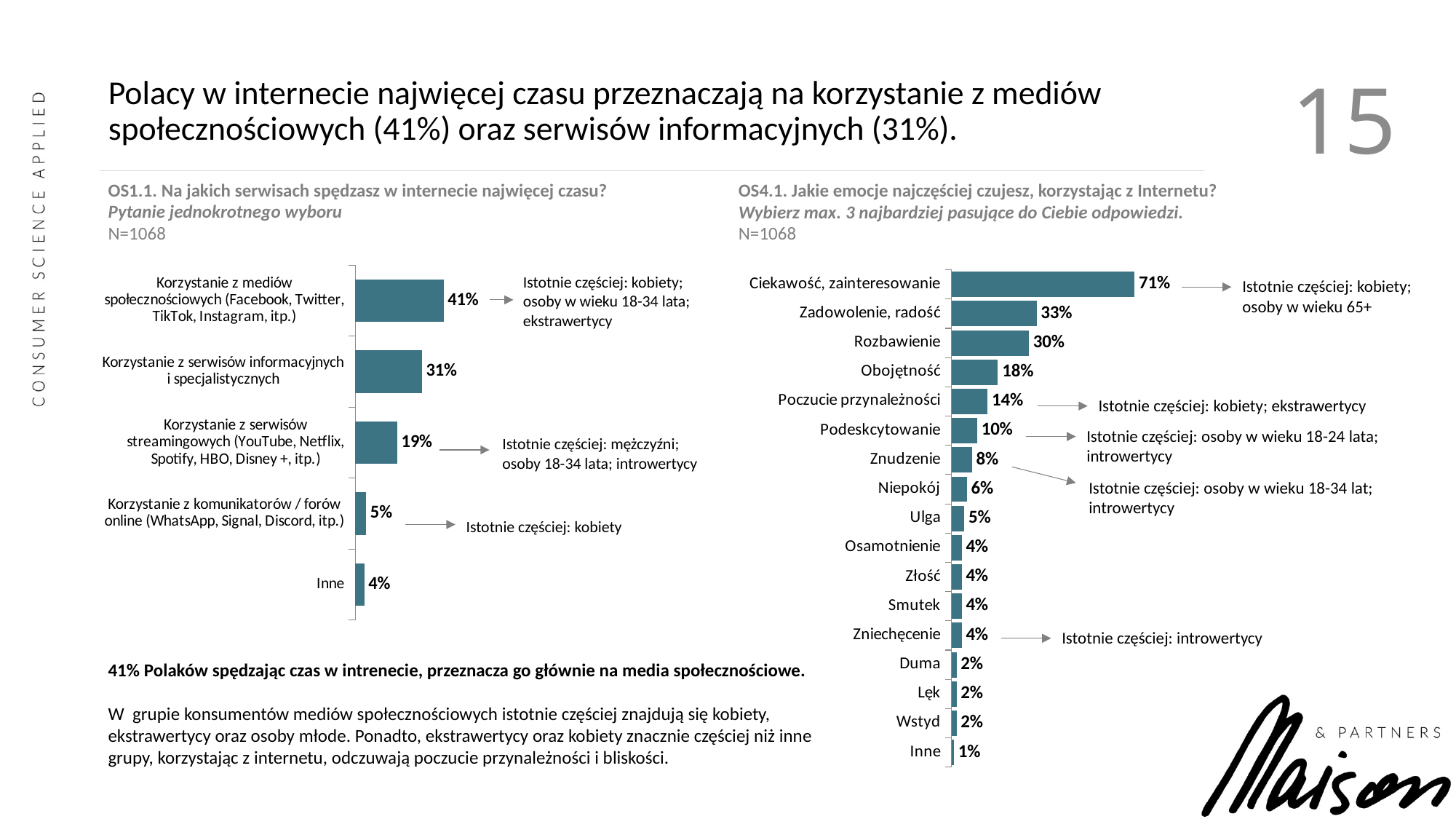
What is the sample size (N) stated for the left chart (OS1.1)? N=1068 In the left chart (OS1.1), what is the value for 'Korzystanie z serwisów informacyjnych i specjalistycznych'? 31% In the left chart (OS1.1), what is the difference between the values for social media (41%) and streaming services (19%)? 22 percentage points In the right chart (OS4.1), which category has the lowest value? Inne In the right chart (OS4.1), how many categories are shown? 17 In the right chart (OS4.1), what is the value for 'Niepokój'? 6% In the left chart (OS1.1), which category has the highest value? Korzystanie z mediów społecznościowych (Facebook, Twitter, TikTok, Instagram, itp.) In the right chart (OS4.1), which is larger: 'Obojętność' or 'Poczucie przynależności'? Obojętność In the left chart (OS1.1), how many categories are shown? 5 In the right chart (OS4.1), what is the value for 'Rozbawienie'? 30% In the right chart (OS4.1), what is the difference between 'Ciekawość, zainteresowanie' and 'Zadowolenie, radość'? 38 percentage points What kind of chart is the left chart (OS1.1)? Bar chart